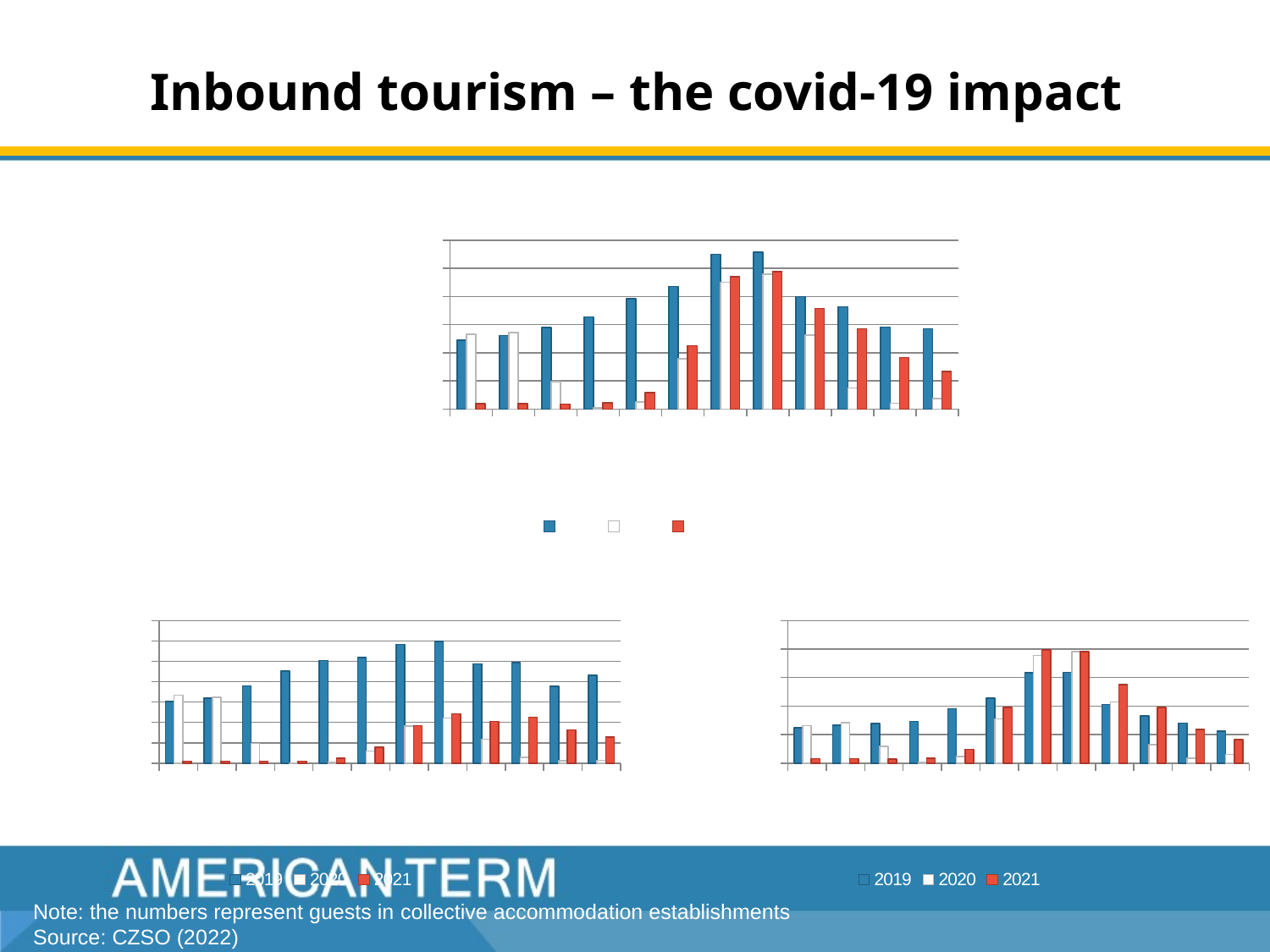
In the bottom-right chart, which colour represents the 2021 series? red What kind of chart is the chart at the bottom right of the slide? bar chart How many series does the legend of the bottom-right chart list? 3 How many groups of bars are plotted in the top chart? 12 How many groups of bars are plotted in the bottom-left chart? 12 What kind of chart is the chart at the top of the slide? bar chart In the bottom-right chart, which series contains the tallest bar? 2021 In the bottom-left chart, which series contains the tallest bar? 2019 In the bottom-right chart, which colour represents the 2019 series? blue How many groups of bars are plotted in the bottom-right chart? 12